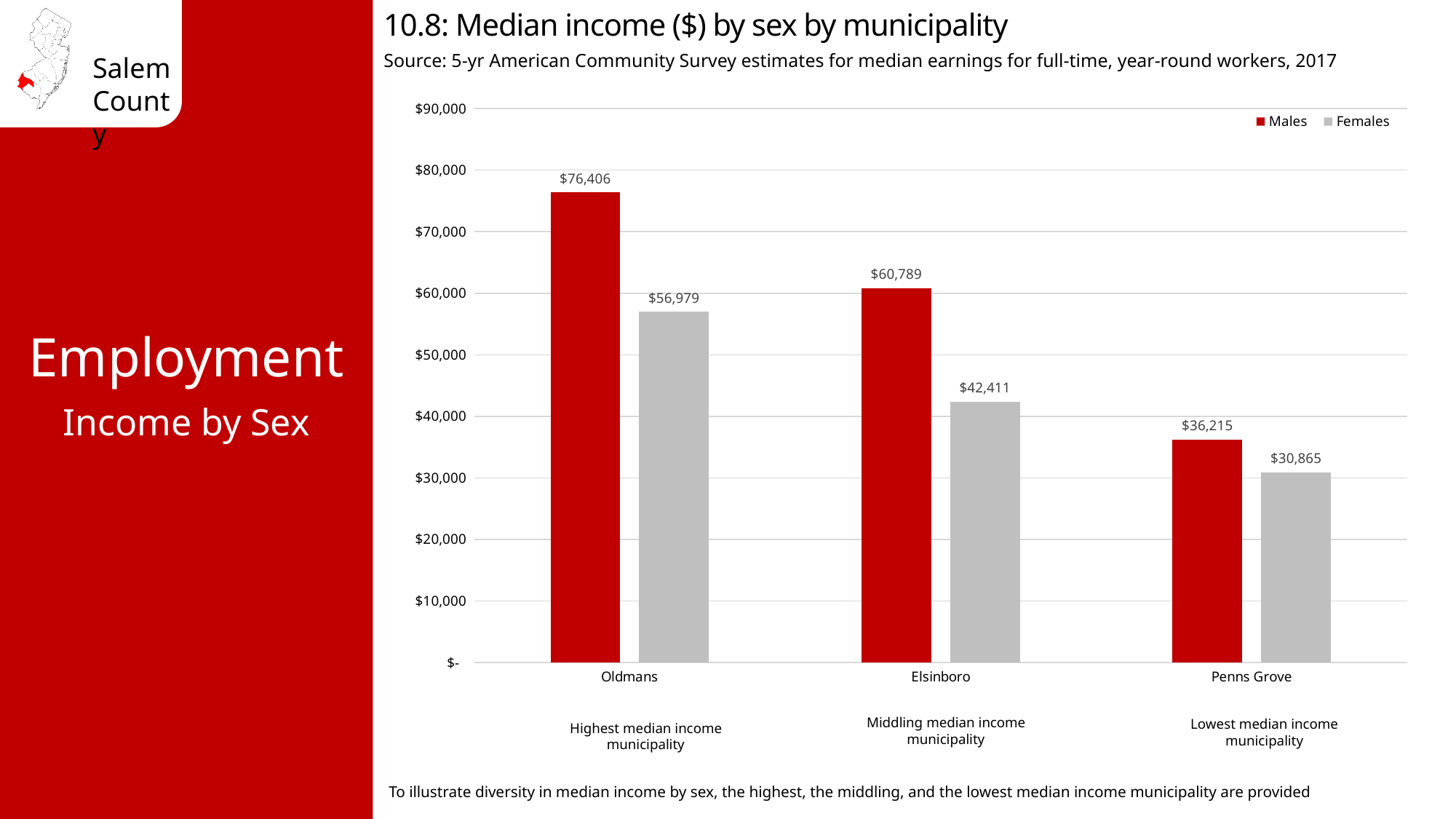
What is the difference between male and female median income in Penns Grove? $5,350 What is the median income for males in Oldmans? $76,406 How many series does the legend list? 2 What is the median income for females in Penns Grove? $30,865 Which municipality has the lowest median income for females? Penns Grove How many municipalities are shown on the x axis? 3 Which is larger: the female median income in Oldmans or the male median income in Penns Grove? Female median income in Oldmans Is the male median income in Elsinboro greater or less than $60,000? greater What is the difference between male and female median income in Oldmans? $19,427 What type of chart is shown on the slide? Bar chart Which municipality has the highest median income for males? Oldmans What is the median income for females in Elsinboro? $42,411